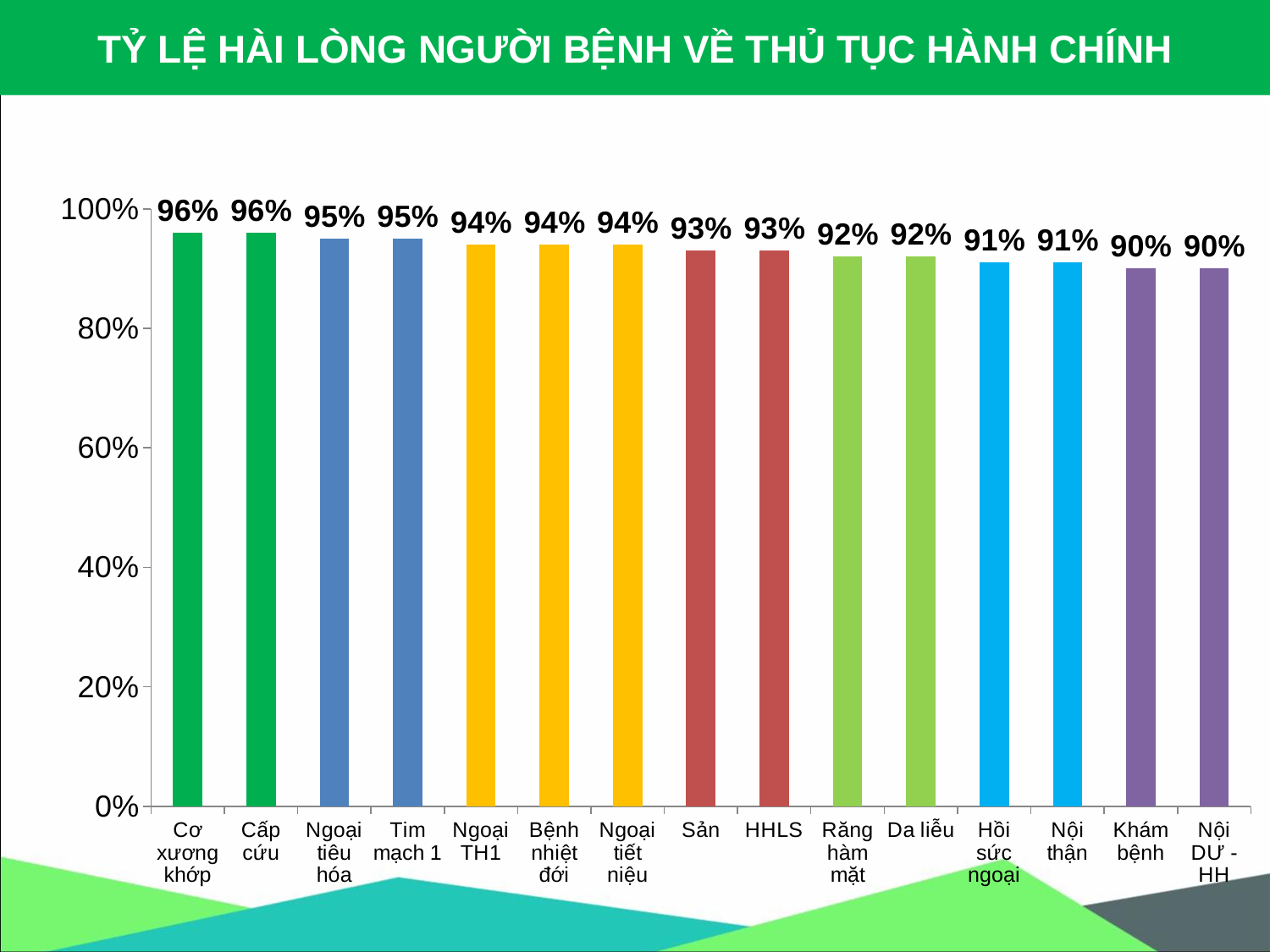
What is the difference between the values for Ngoại tiêu hóa and HHLS? 2% What kind of chart is shown on the slide? bar chart What is the value for Cơ xương khớp? 96% What is the value for Khám bệnh? 90% Do the values rise or fall from left to right along the x axis? fall What is the value for Sản? 93% Is the value for Hồi sức ngoại greater or less than 80%? greater What is the value for Da liễu? 92% What is the difference between the values for Cấp cứu and Nội DƯ - HH? 6% How many categories are shown on the x axis? 15 Which is larger, the value for Tim mạch 1 or the value for Răng hàm mặt? Tim mạch 1 What is the value for Nội thận? 91%